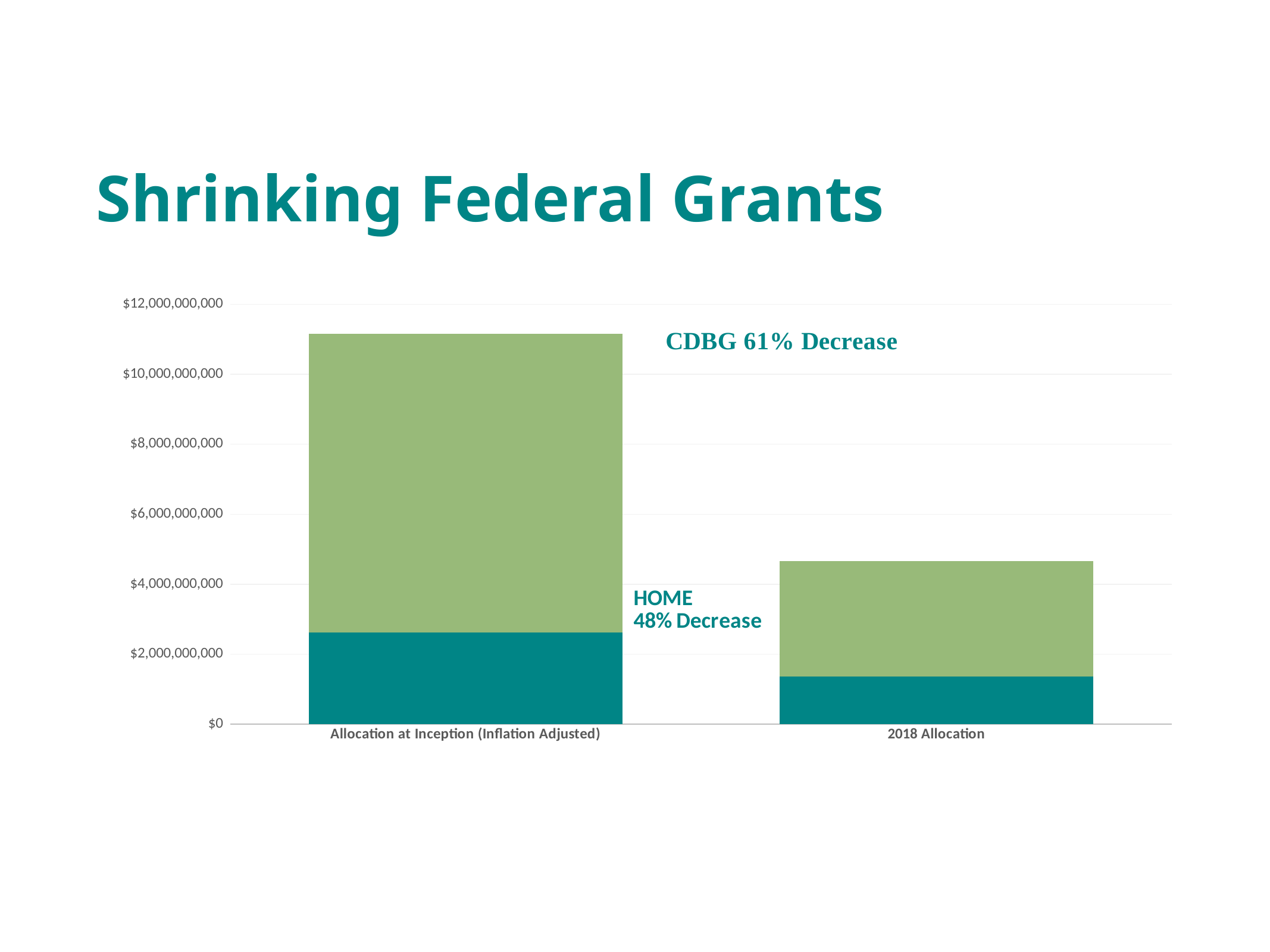
What kind of chart is shown on the slide? Stacked bar chart How many categories are shown on the x axis of the chart? 2 Is the total bar for 2018 Allocation greater or less than $4,000,000,000? greater Which category has the lowest total bar? 2018 Allocation Which category has the taller bar, Allocation at Inception (Inflation Adjusted) or 2018 Allocation? Allocation at Inception (Inflation Adjusted) Is the dark teal (bottom) segment of the Allocation at Inception (Inflation Adjusted) bar greater or less than $2,000,000,000? greater Is the total bar for Allocation at Inception (Inflation Adjusted) greater or less than $10,000,000,000? greater According to the annotation on the chart, by what percentage did HOME decrease? 48% Do the bar totals rise or fall from Allocation at Inception (Inflation Adjusted) to 2018 Allocation? Fall According to the annotation on the chart, by what percentage did CDBG decrease? 61%